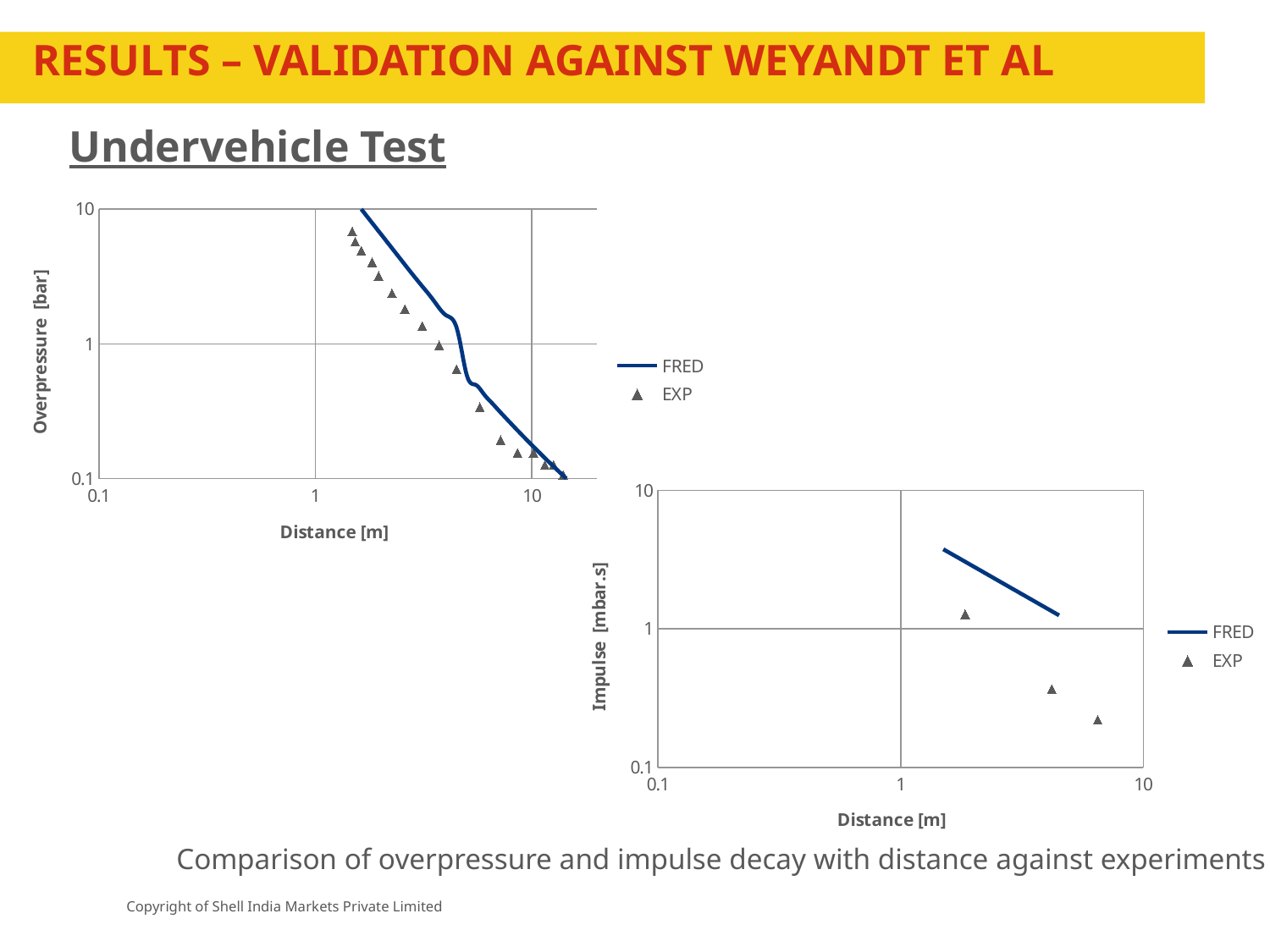
In the Overpressure [bar] chart (top left), is the EXP value at the smallest distance (around 1.5 m) greater or less than 1? greater In the Overpressure [bar] vs Distance [m] chart (top left), how many series does the legend list? 2 What kind of chart is the Overpressure [bar] vs Distance [m] chart (top left)? line chart In the Overpressure [bar] chart (top left), does the FRED line rise or fall as distance increases? falls In the Impulse [mbar.s] chart (bottom right), which series is drawn as a solid line rather than triangle markers? FRED In the Impulse [mbar.s] chart (bottom right), is the EXP value at the largest distance (around 6-7 m) greater or less than 1? less In the Impulse [mbar.s] chart (bottom right), does the FRED line rise or fall as distance increases? falls What is the y-axis title of the top-left chart? Overpressure [bar] In the Overpressure [bar] chart (top left), is the FRED value at a distance of 10 m greater or less than 1? less In the Impulse [mbar.s] chart (bottom right), how many series does the legend list? 2 In the Impulse [mbar.s] vs Distance [m] chart (bottom right), how many EXP data points are plotted? 3 In the Impulse [mbar.s] chart (bottom right), at a distance of about 4 m, which series has the higher value, FRED or EXP? FRED